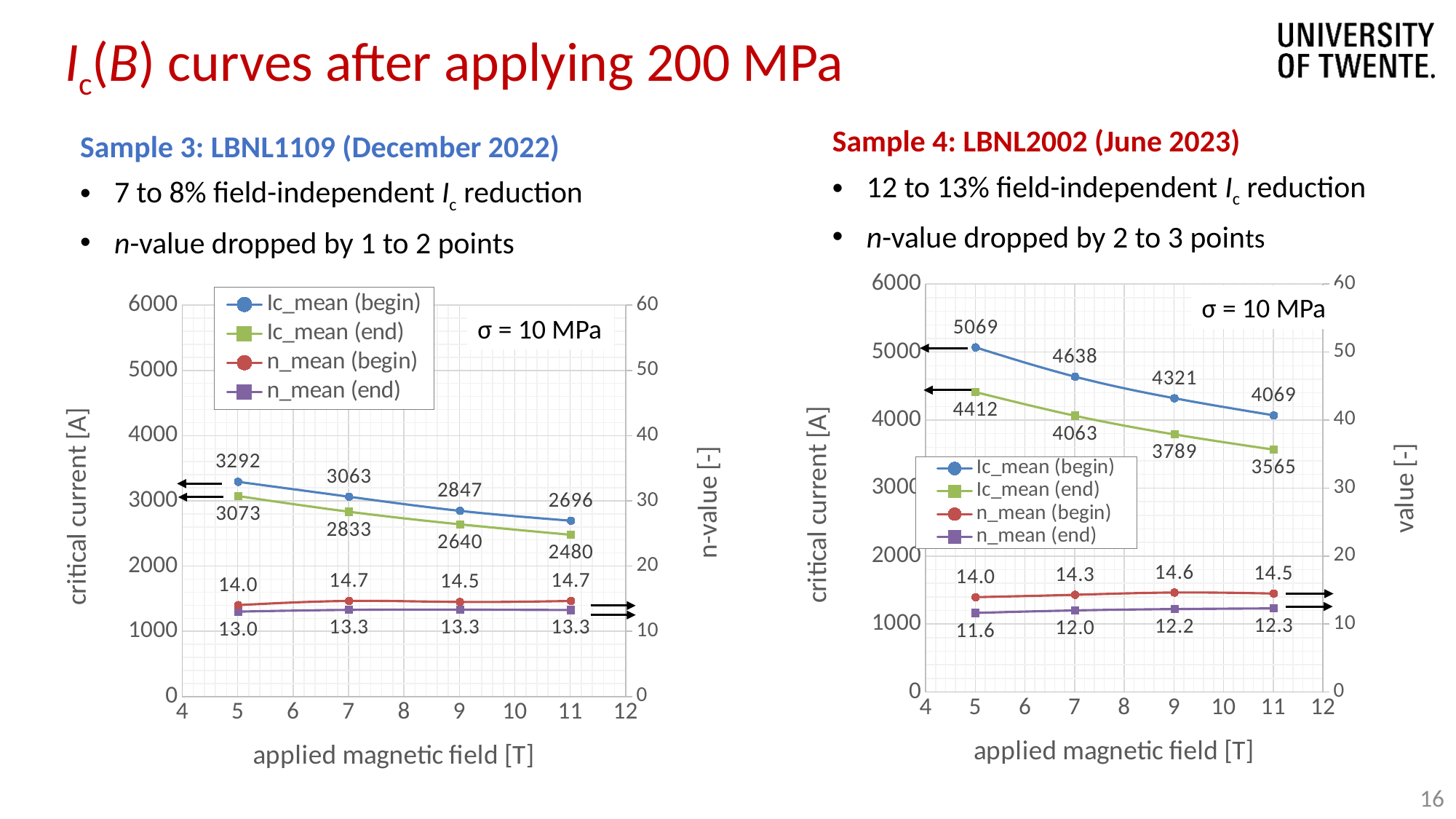
In the Sample 4: LBNL2002 chart, does Ic_mean (begin) rise or fall as the applied magnetic field increases? fall In the Sample 3: LBNL1109 chart, what is the n_mean (end) value at 5 T? 13.0 In the Sample 3: LBNL1109 chart, what is the difference between Ic_mean (begin) and Ic_mean (end) at 7 T? 230 In the Sample 3: LBNL1109 chart, how many series does the legend list? 4 In the Sample 4: LBNL2002 chart, what is the Ic_mean (end) value at 5 T? 4412 In the Sample 4: LBNL2002 chart, what is the n_mean (end) value at 7 T? 12.0 In the Sample 4: LBNL2002 chart, what is the Ic_mean (begin) value at 9 T? 4321 What type of chart is the Sample 3: LBNL1109 chart? line chart In the Sample 3: LBNL1109 chart, what is the Ic_mean (end) value at 11 T? 2480 In the Sample 4: LBNL2002 chart, what is the difference between Ic_mean (begin) and Ic_mean (end) at 11 T? 504 In the Sample 4: LBNL2002 chart, at which applied magnetic field is Ic_mean (begin) lowest? 11 T In the Sample 3: LBNL1109 chart, what is the Ic_mean (begin) value at 5 T? 3292